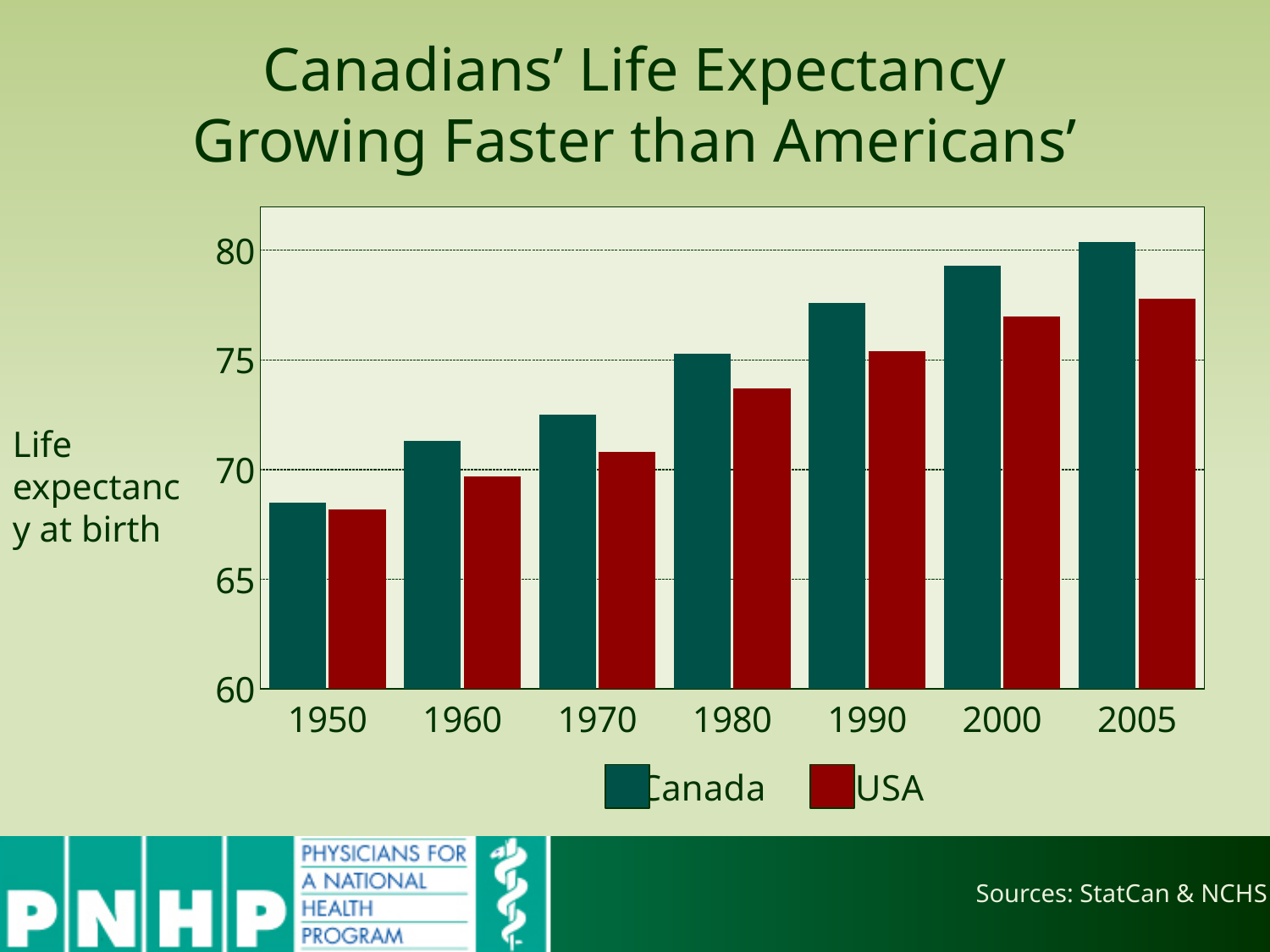
What kind of chart is shown on the slide? bar chart In which year is the USA value lowest? 1950 Is the value for USA in 1980 greater or less than 75? less Do the Canada values rise or fall from 1950 to 2005? rise In which year is the Canada value highest? 2005 Is the value for Canada in 1950 greater or less than 70? less Is the value for USA in 2005 greater or less than 80? less Which colour represents USA in the legend? red In 1990, which is larger, the Canada value or the USA value? Canada How many years are shown along the x axis? 7 How many series does the legend list? 2